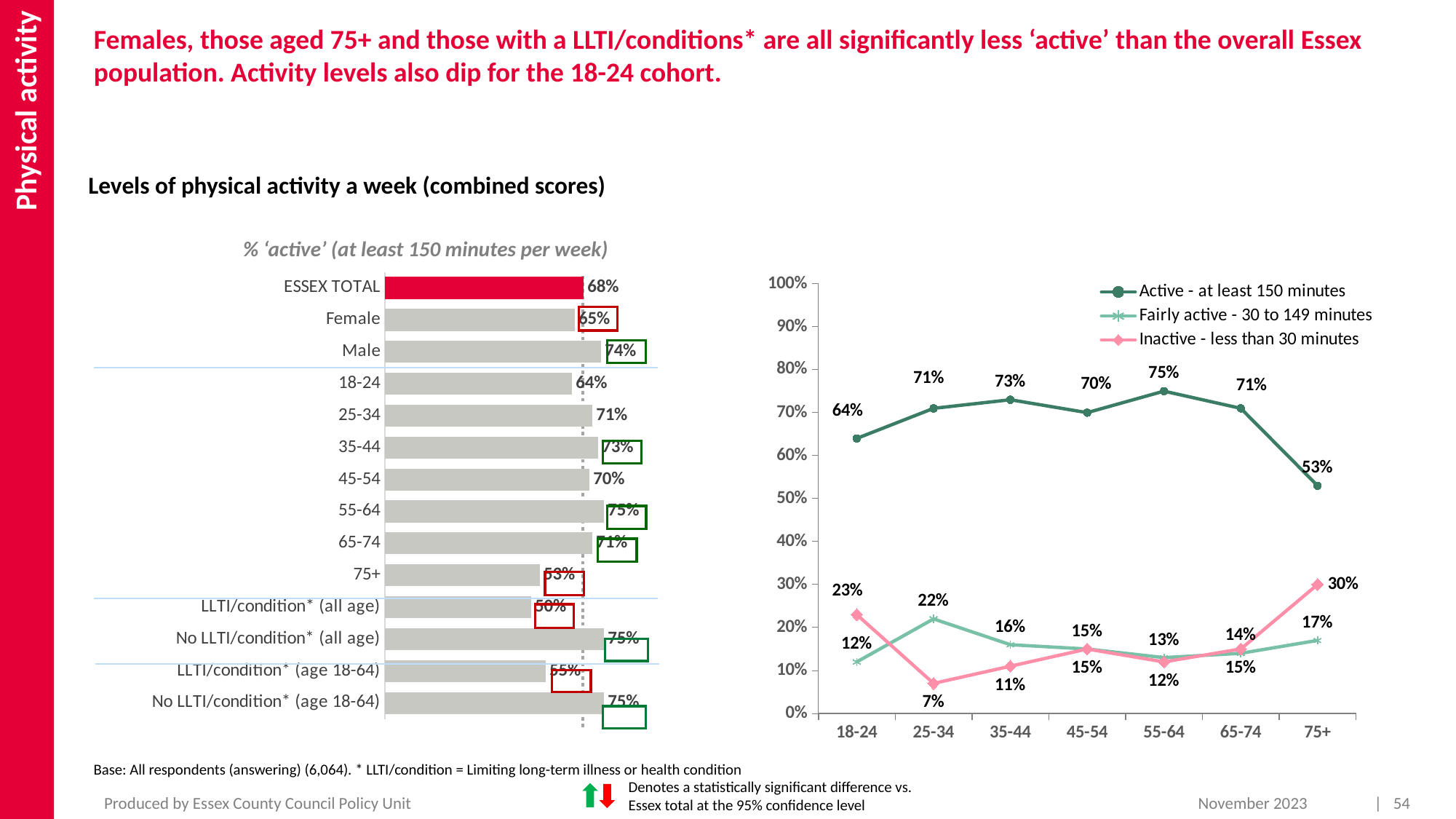
In the right-hand line chart, what is the value of 'Inactive - less than 30 minutes' for the 75+ age group? 30% In the left bar chart '% active (at least 150 minutes per week)', which age group has the lowest value? 75+ In the left bar chart '% active (at least 150 minutes per week)', what is the value for ESSEX TOTAL? 68% How many age groups are shown on the x axis of the right-hand line chart? 7 In the right-hand line chart, which age group has the highest value for 'Active - at least 150 minutes'? 55-64 What kind of chart is the chart on the left of the slide? Bar chart How many series does the legend of the right-hand line chart list? 3 In the left bar chart '% active (at least 150 minutes per week)', what is the value for Male? 74% In the right-hand line chart, which age group has the lowest value for 'Inactive - less than 30 minutes'? 25-34 In the right-hand line chart, what is the value of 'Fairly active - 30 to 149 minutes' for the 25-34 age group? 22% In the left bar chart '% active (at least 150 minutes per week)', which is larger, the value for 18-24 or the value for 25-34? 25-34 In the left bar chart '% active (at least 150 minutes per week)', what is the difference between the Male and Female values? 9 percentage points